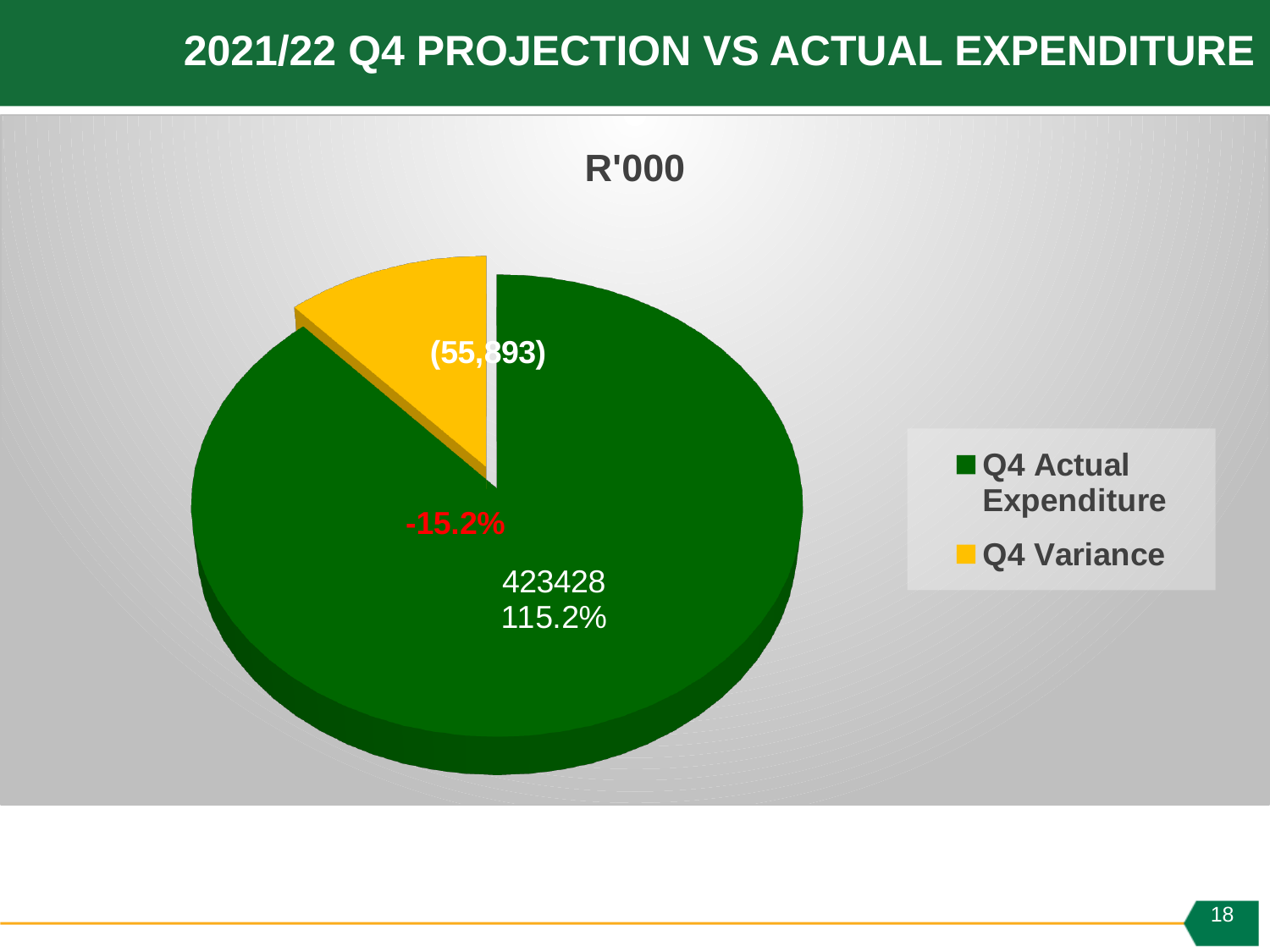
What value is shown for Q4 Variance? (55,893) What colour is the Q4 Variance slice? yellow What is the title of the chart? R'000 How many series does the legend list? 2 How many slices does the pie chart have? 2 Which slice is the smallest in the pie chart? Q4 Variance Which is larger, Q4 Actual Expenditure or Q4 Variance? Q4 Actual Expenditure Which slice is the largest in the pie chart? Q4 Actual Expenditure What kind of chart is shown on the slide? pie chart What percentage is shown for the Q4 Variance slice? -15.2% What value is shown for Q4 Actual Expenditure? 423428 What percentage is shown for the Q4 Actual Expenditure slice? 115.2%